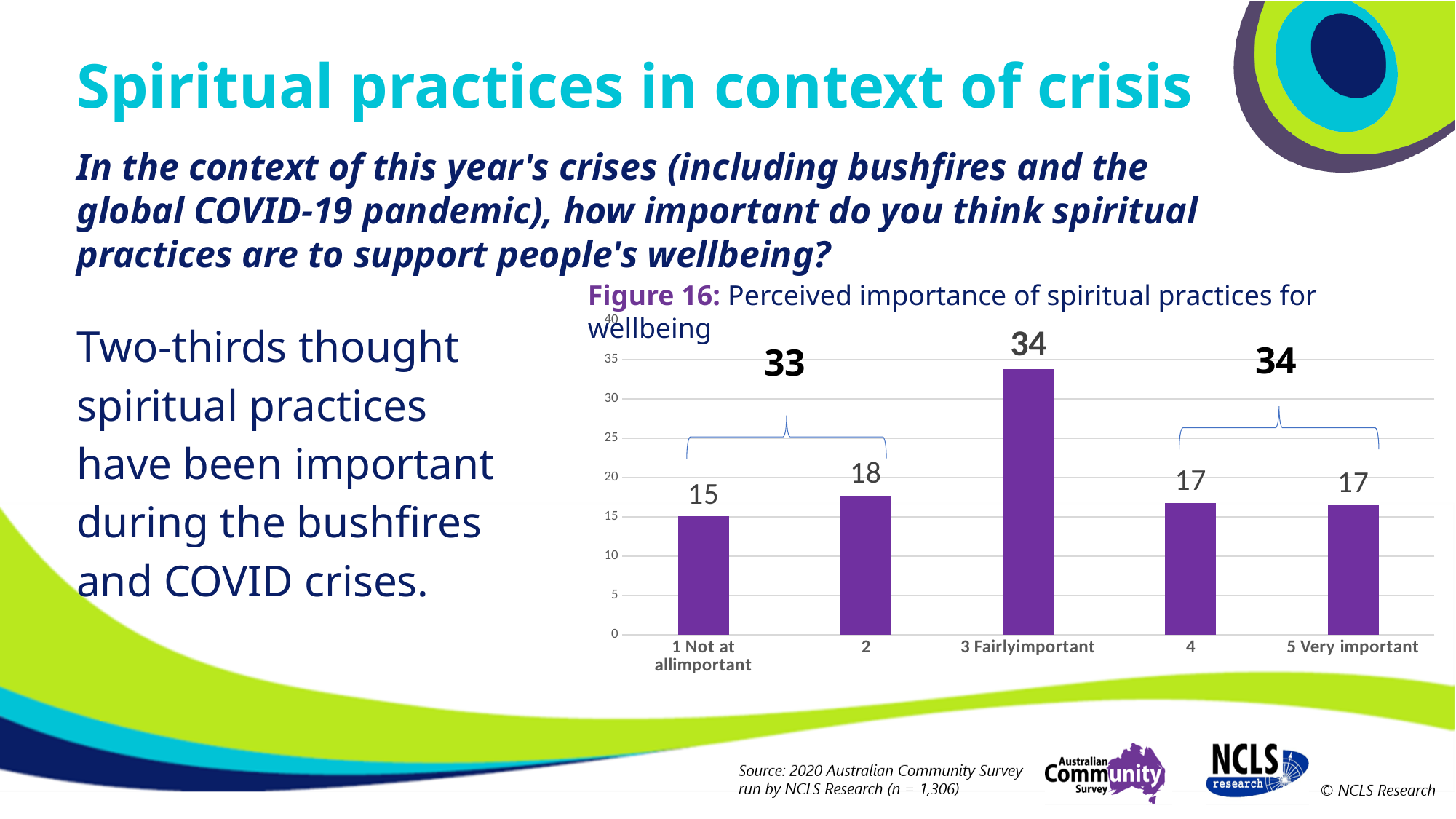
What kind of chart is shown on the slide? Bar chart What is the combined value shown by the bracket over categories '1 Not at all important' and '2'? 33 Which is larger, the value for category '2' or the value for category '4'? 2 Which category has the highest value? 3 Fairly important What is the value for category '2'? 18 How many categories are shown on the x axis? 5 What is the figure number given in the chart title? Figure 16 What is the value for the category '1 Not at all important'? 15 Which category has the lowest value? 1 Not at all important What is the value for the category '3 Fairly important'? 34 What is the difference between the values for '3 Fairly important' and '1 Not at all important'? 19 What is the value for the category '5 Very important'? 17